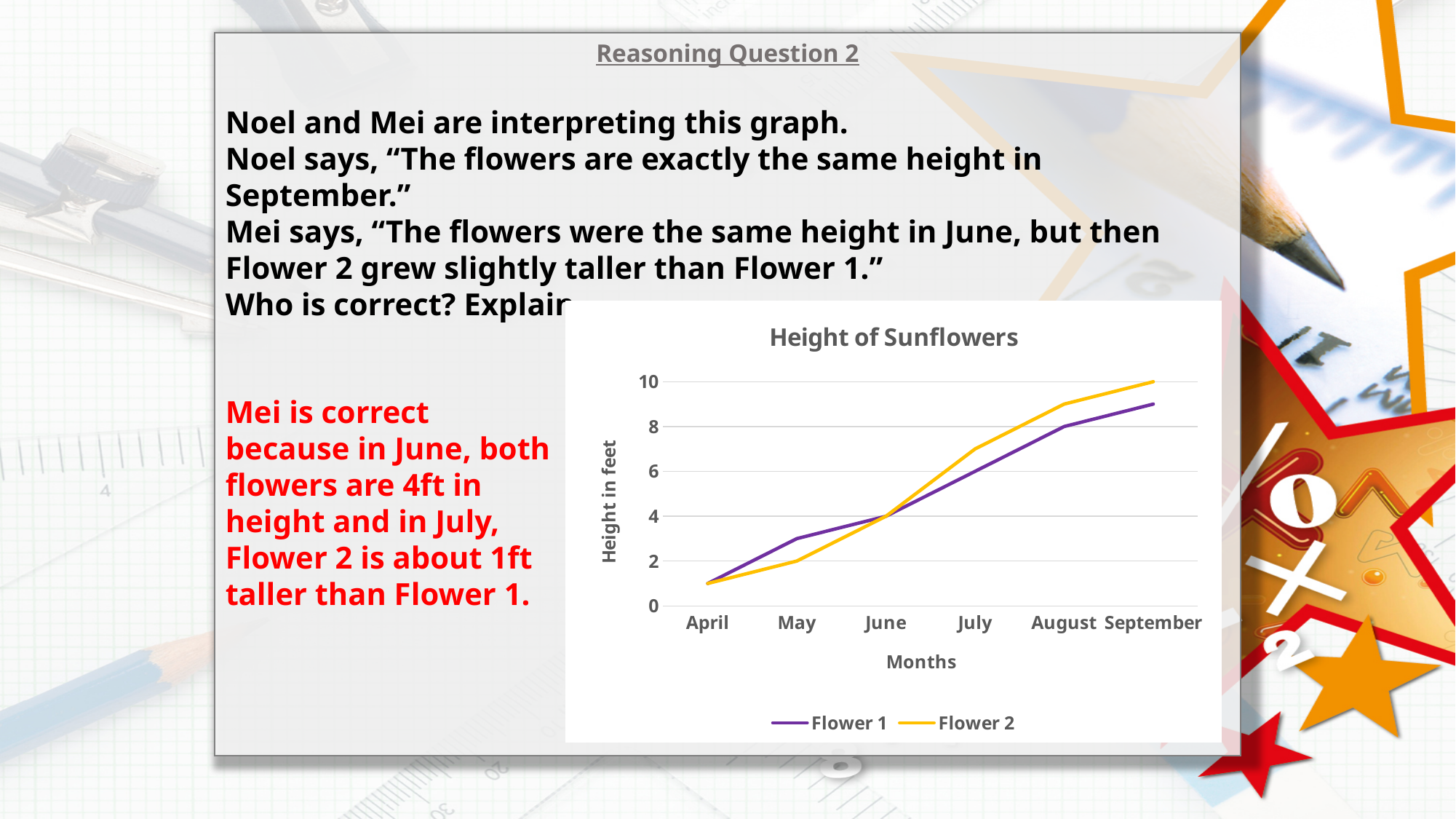
What is the label on the vertical axis of the chart? Height in feet In May, which flower is taller, Flower 1 or Flower 2? Flower 1 What is the height of Flower 2 in May? 2 What is the height of Flower 1 in August? 8 In September, which flower is taller, Flower 1 or Flower 2? Flower 2 Is the height of Flower 2 in July greater or less than 6? greater Do the heights of the flowers rise or fall from April to September? rise What kind of chart is shown on the slide? line chart How many series does the legend of the Height of Sunflowers chart list? 2 How many months are shown on the x axis of the Height of Sunflowers chart? 6 What is the height of Flower 1 in June? 4 What is the height of Flower 2 in September? 10